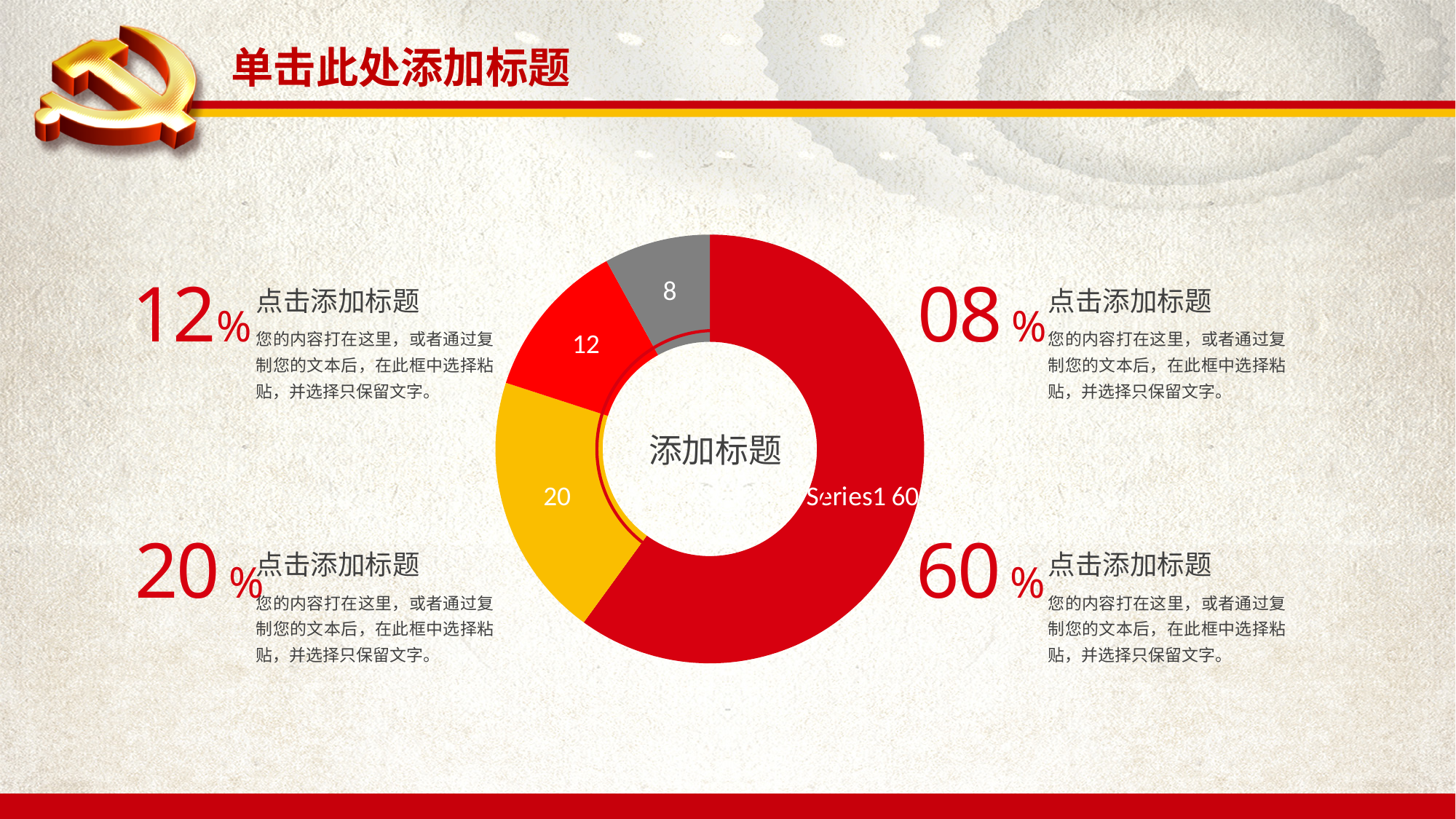
Which slice is larger, the yellow slice or the grey slice? the yellow slice What share of the whole doughnut does the slice labelled 60 represent? 60% What is the difference between the bright red slice (12) and the grey slice (8)? 4 What is the value of the largest slice in the doughnut chart? 60 What value is printed on the bright red slice of the doughnut chart? 12 What kind of chart is shown on the slide? doughnut chart What is the difference between the largest slice (60) and the yellow slice (20)? 40 What text is shown in the centre of the doughnut chart? 添加标题 What value is printed on the yellow slice of the doughnut chart? 20 What is the value of the smallest slice in the doughnut chart? 8 How many slices does the doughnut chart have? 4 What value is printed on the grey slice of the doughnut chart? 8